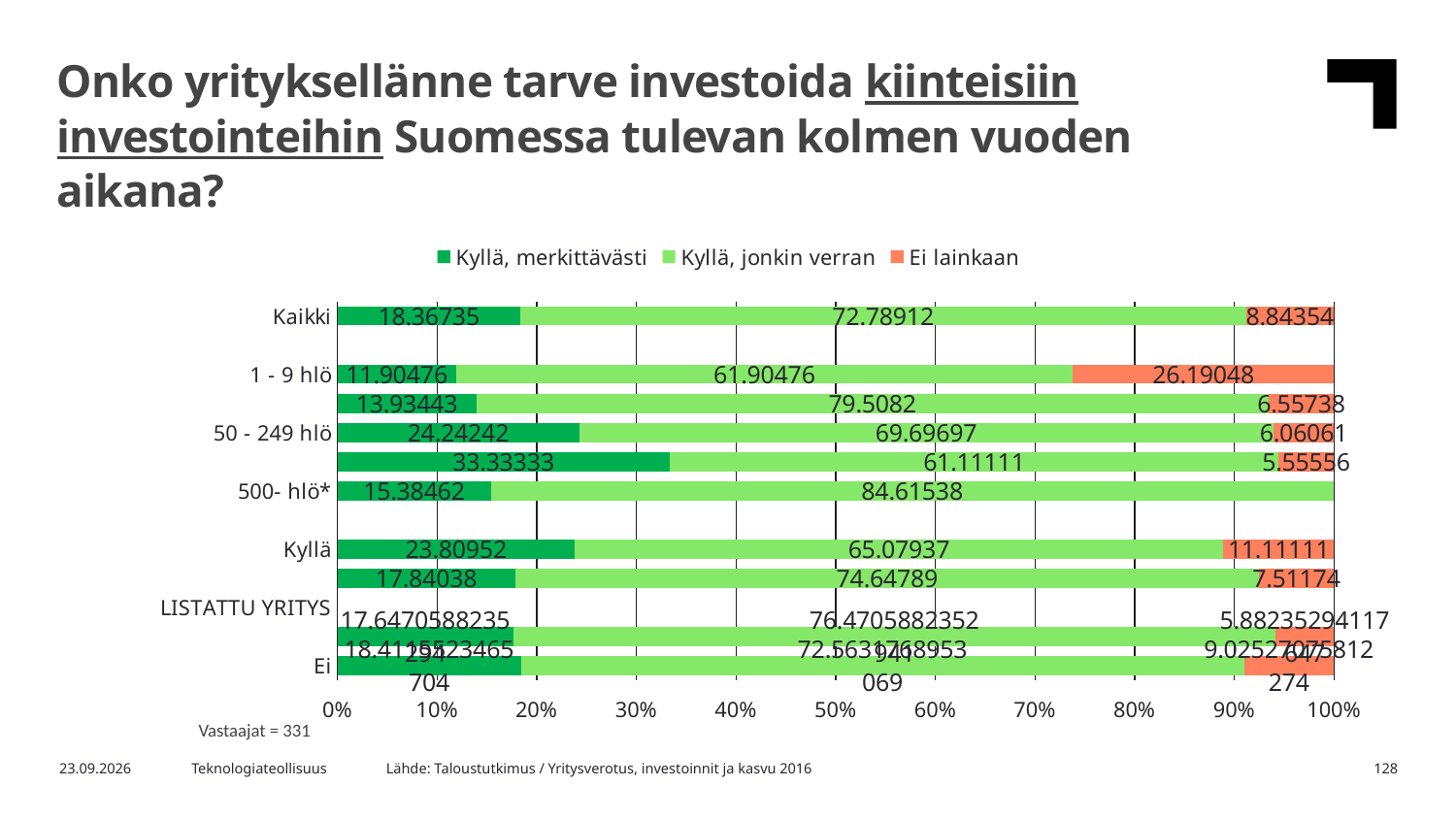
What is the value of "Ei lainkaan" for the Kaikki bar? 8.84354 What kind of chart is shown on the slide? Stacked bar chart What is the value of "Ei lainkaan" for the 1 - 9 hlö bar? 26.19048 Which bar has the larger "Ei lainkaan" value, Kaikki or 1 - 9 hlö? 1 - 9 hlö Which category has the highest "Ei lainkaan" value? 1 - 9 hlö What is the value of "Kyllä, merkittävästi" for the Kaikki bar? 18.36735 What is the value of "Kyllä, jonkin verran" for the 50 - 249 hlö bar? 69.69697 What is the value of "Kyllä, jonkin verran" for the 500- hlö* bar? 84.61538 How many series does the legend list? 3 What is the difference between the "Kyllä, jonkin verran" values for Kaikki and 1 - 9 hlö? 10.88436 What is the value of "Kyllä, merkittävästi" for the Kyllä bar? 23.80952 Is the "Kyllä, merkittävästi" value for the 500- hlö* bar greater or less than 20%? less